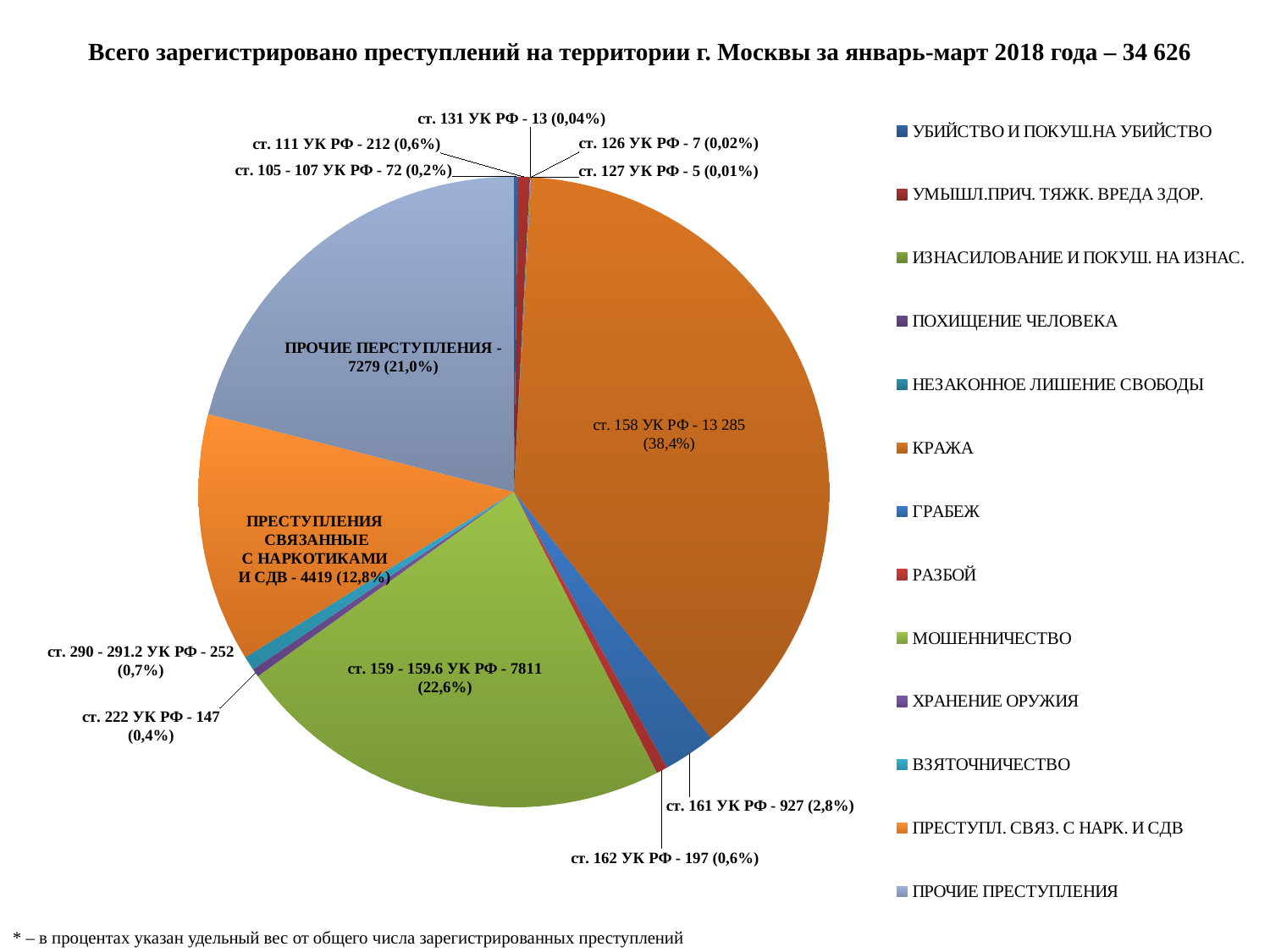
What value is shown for ПРЕСТУПЛЕНИЯ СВЯЗАННЫЕ С НАРКОТИКАМИ И СДВ? 4419 What is the total number of registered crimes stated in the chart title? 34 626 What share of the pie does ст. 159 - 159.6 УК РФ account for? 22,6% Which slice of the pie chart is the largest? ст. 158 УК РФ (КРАЖА) Which slice of the pie chart is the smallest? ст. 127 УК РФ What is the difference between the values for ст. 161 УК РФ and ст. 162 УК РФ? 730 What kind of chart is shown on the slide? pie chart How many categories does the legend of the pie chart list? 13 What percentage share is shown for ПРОЧИЕ ПРЕСТУПЛЕНИЯ? 21,0% What value is shown for ст. 222 УК РФ? 147 What value is shown for ст. 158 УК РФ? 13 285 Which is larger, the value for ст. 111 УК РФ or the value for ст. 290 - 291.2 УК РФ? ст. 290 - 291.2 УК РФ